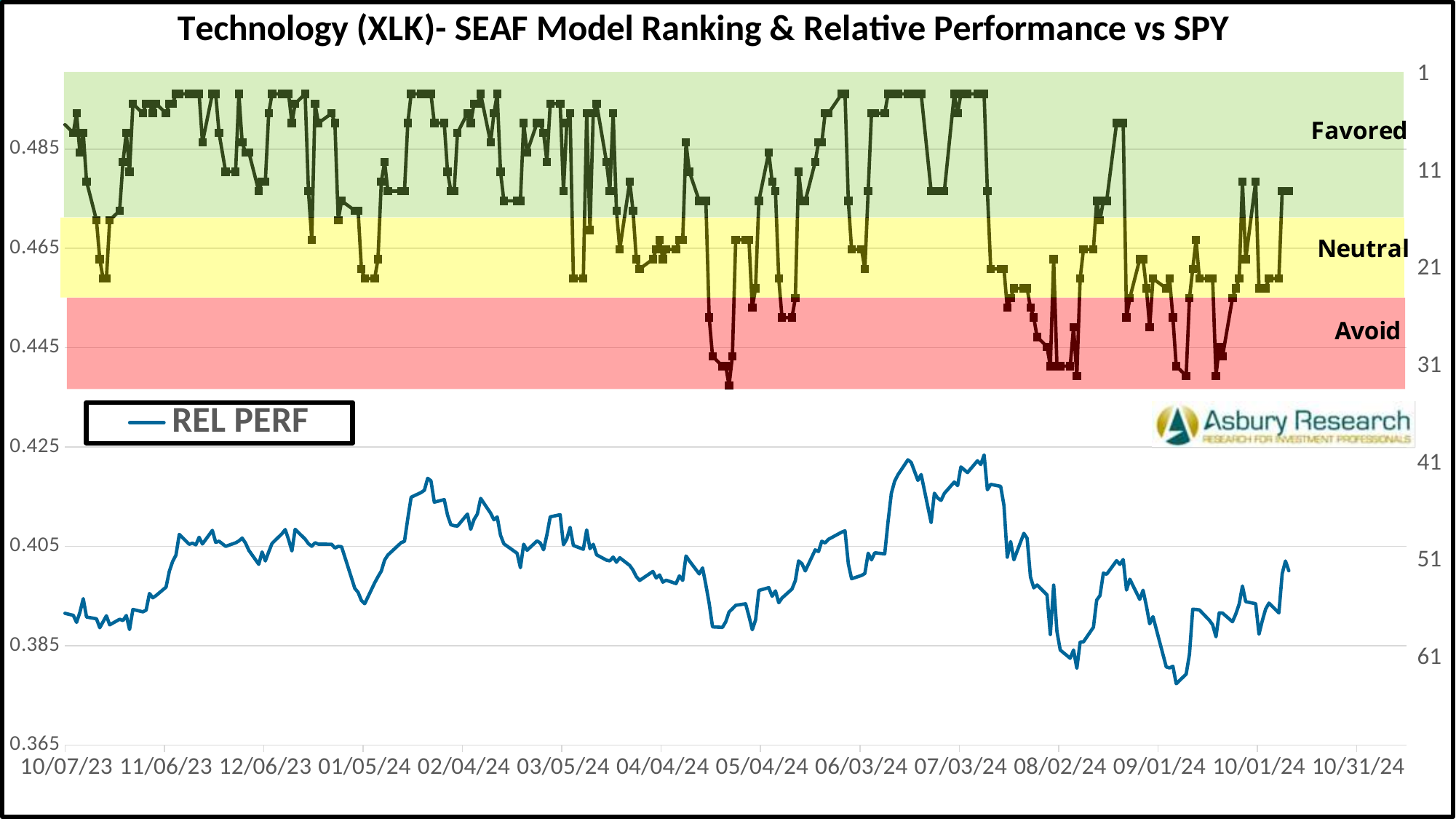
Is the REL PERF value at 09/01/24 greater or less than 0.405? less Is the REL PERF value at 07/03/24 greater or less than 0.405? greater How many series does the chart's legend list? 1 Does the REL PERF line rise or fall between 10/07/23 and 11/06/23? rise Does the REL PERF line rise or fall between 07/03/24 and 08/02/24? fall Which is larger, the REL PERF value at 07/03/24 or at 10/07/23? 07/03/24 What kind of chart is shown on the slide? Line chart What is the title of the chart? Technology (XLK)- SEAF Model Ranking & Relative Performance vs SPY How many date labels are shown along the x axis? 14 What is the name of the series shown in the legend? REL PERF Is the REL PERF value at 10/07/23 greater or less than 0.405? less